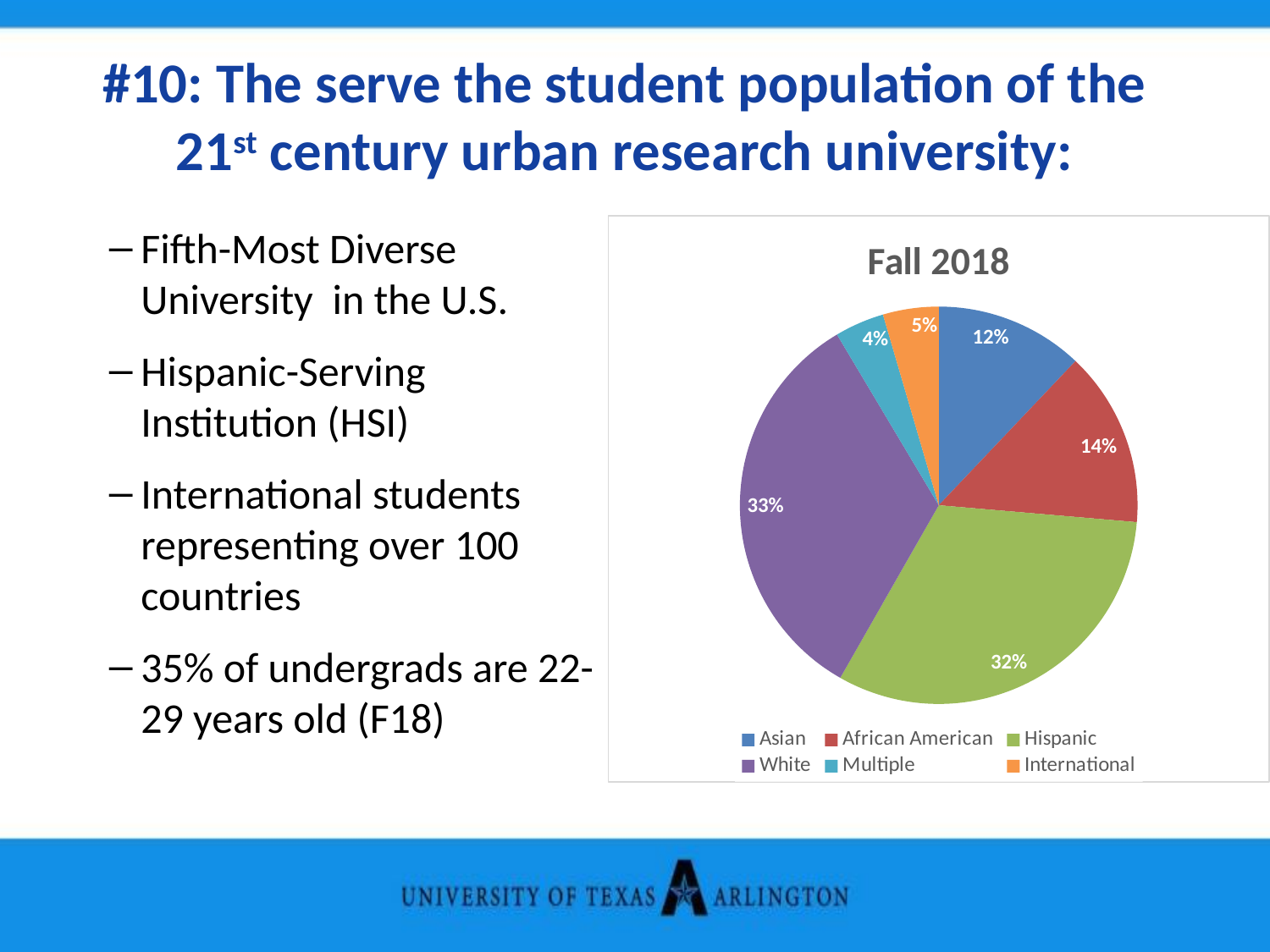
What is the title of the chart? Fall 2018 Which category has the largest slice of the pie? White What is the difference in percentage points between the White and Asian slices? 21 What percentage of the pie is African American? 14% What colour is the Hispanic slice? green Which is larger, the African American slice or the International slice? African American How many categories does the legend list? 6 What kind of chart is shown on the slide? pie chart Which category has the smallest slice of the pie? Multiple What percentage of the pie is Asian? 12% What percentage of the pie is Hispanic? 32% What percentage of the pie is International? 5%